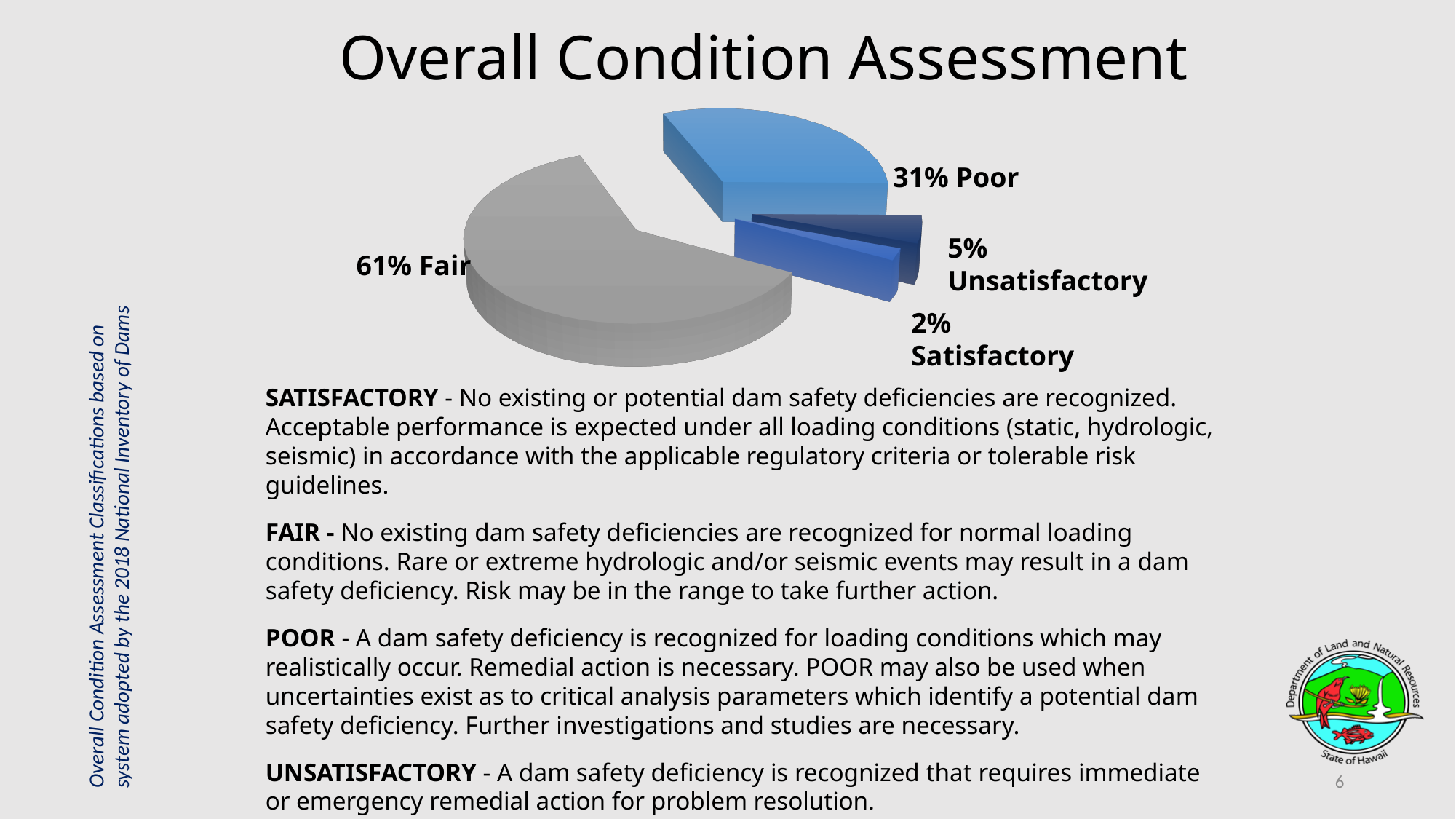
What percentage of dams are rated Unsatisfactory? 5% What kind of chart is shown on the slide? Pie chart Which condition category has the smallest share of the pie? Satisfactory What is the difference in percentage points between the Fair and Poor slices? 30 What percentage of dams are rated Satisfactory? 2% What percentage of dams are rated Poor? 31% What colour is the Fair slice of the pie chart? Grey How many categories are shown in the pie chart? 4 Which condition category has the largest share of the pie? Fair What percentage of dams are rated Fair? 61% What is the combined percentage of the Poor and Unsatisfactory slices? 36% Which is larger, the Unsatisfactory slice or the Satisfactory slice? Unsatisfactory